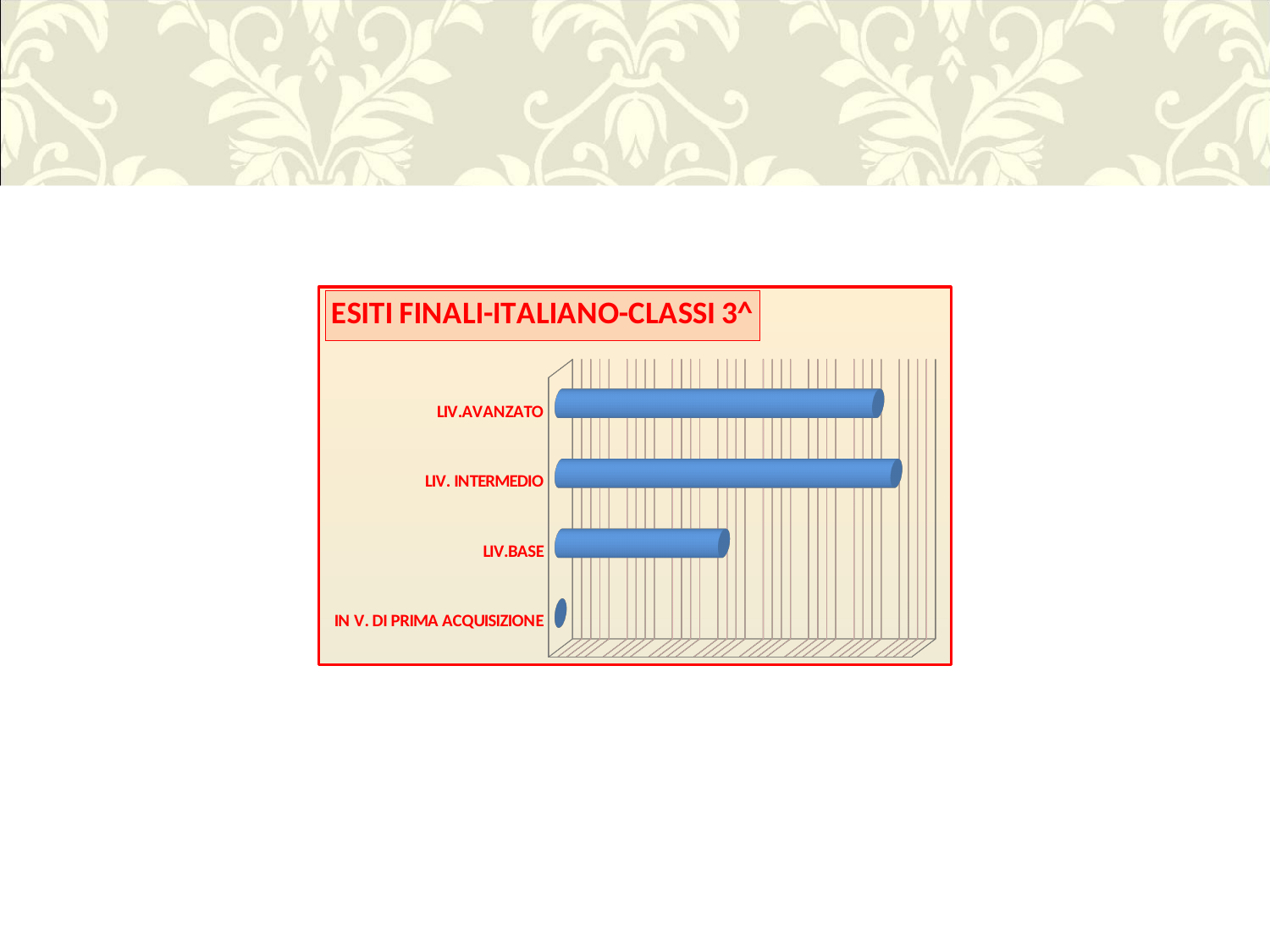
Which is larger, the value for LIV.BASE or the value for LIV.AVANZATO? LIV.AVANZATO What is the title of the chart? ESITI FINALI-ITALIANO-CLASSI 3^ Which is larger, the value for LIV. INTERMEDIO or the value for LIV.BASE? LIV. INTERMEDIO Which category is listed at the top of the chart? LIV.AVANZATO Which category has the lowest value in the chart? IN V. DI PRIMA ACQUISIZIONE Are the bars in the chart horizontal or vertical? horizontal Which category has the highest value in the chart? LIV. INTERMEDIO How many categories are plotted in the chart? 4 Which is larger, the value for LIV.BASE or the value for IN V. DI PRIMA ACQUISIZIONE? LIV.BASE What kind of chart is shown on the slide? bar chart